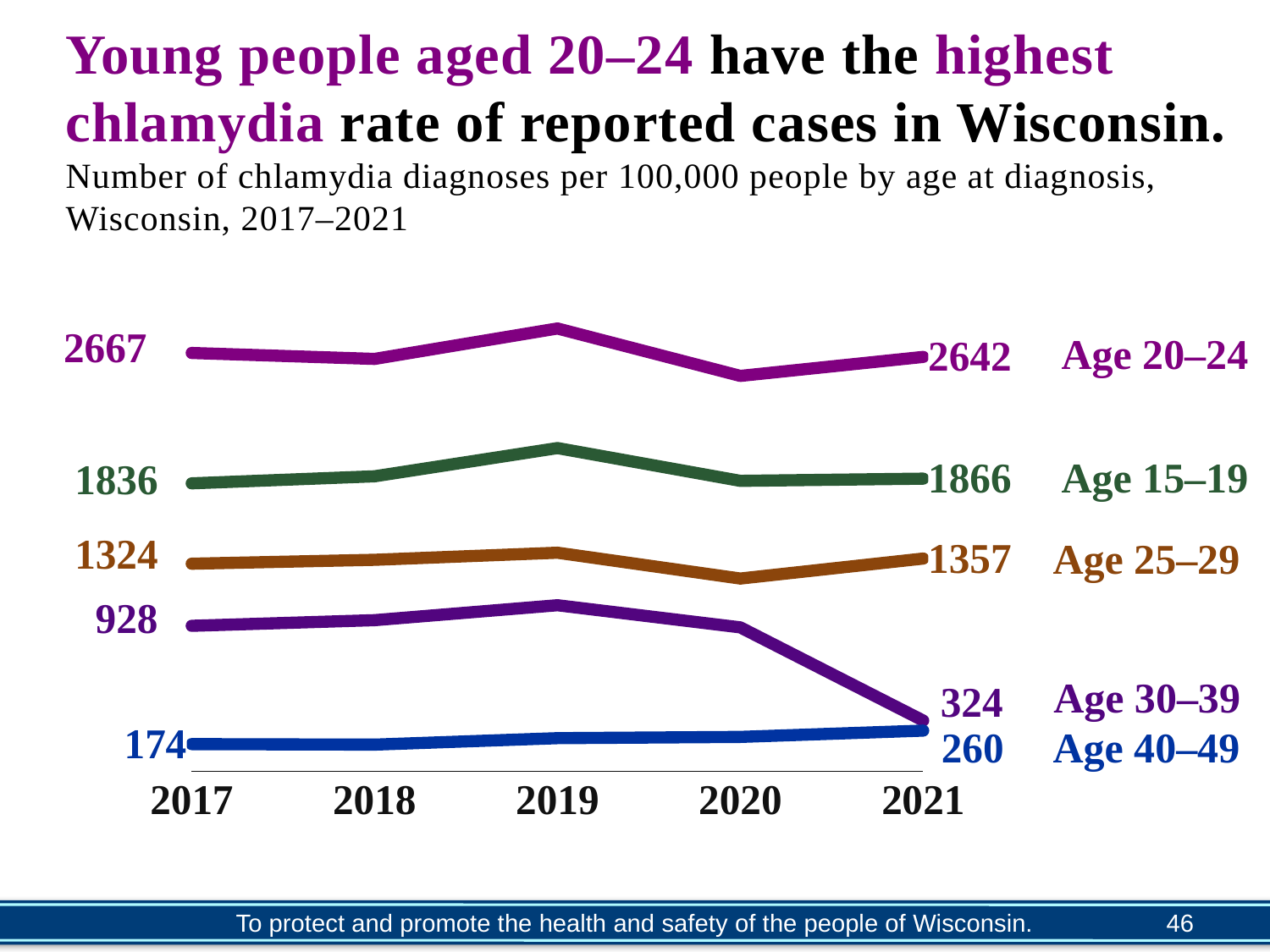
How many years are shown on the x axis? 5 How many age groups are plotted on the chart? 5 Which age group had the lowest chlamydia rate in 2017? Age 40–49 What kind of chart is shown on the slide? Line chart What is the difference between the 2021 rates for Age 20–24 and Age 15–19? 776 For Age 25–29, was the chlamydia rate higher in 2017 or 2021? 2021 What was the chlamydia rate for Age 20–24 in 2017? 2667 By how much did the chlamydia rate for Age 30–39 decrease from 2017 to 2021? 604 What was the chlamydia rate for Age 15–19 in 2021? 1866 What was the chlamydia rate for Age 30–39 in 2021? 324 Which age group had the highest chlamydia rate in 2021? Age 20–24 What was the chlamydia rate for Age 40–49 in 2017? 174